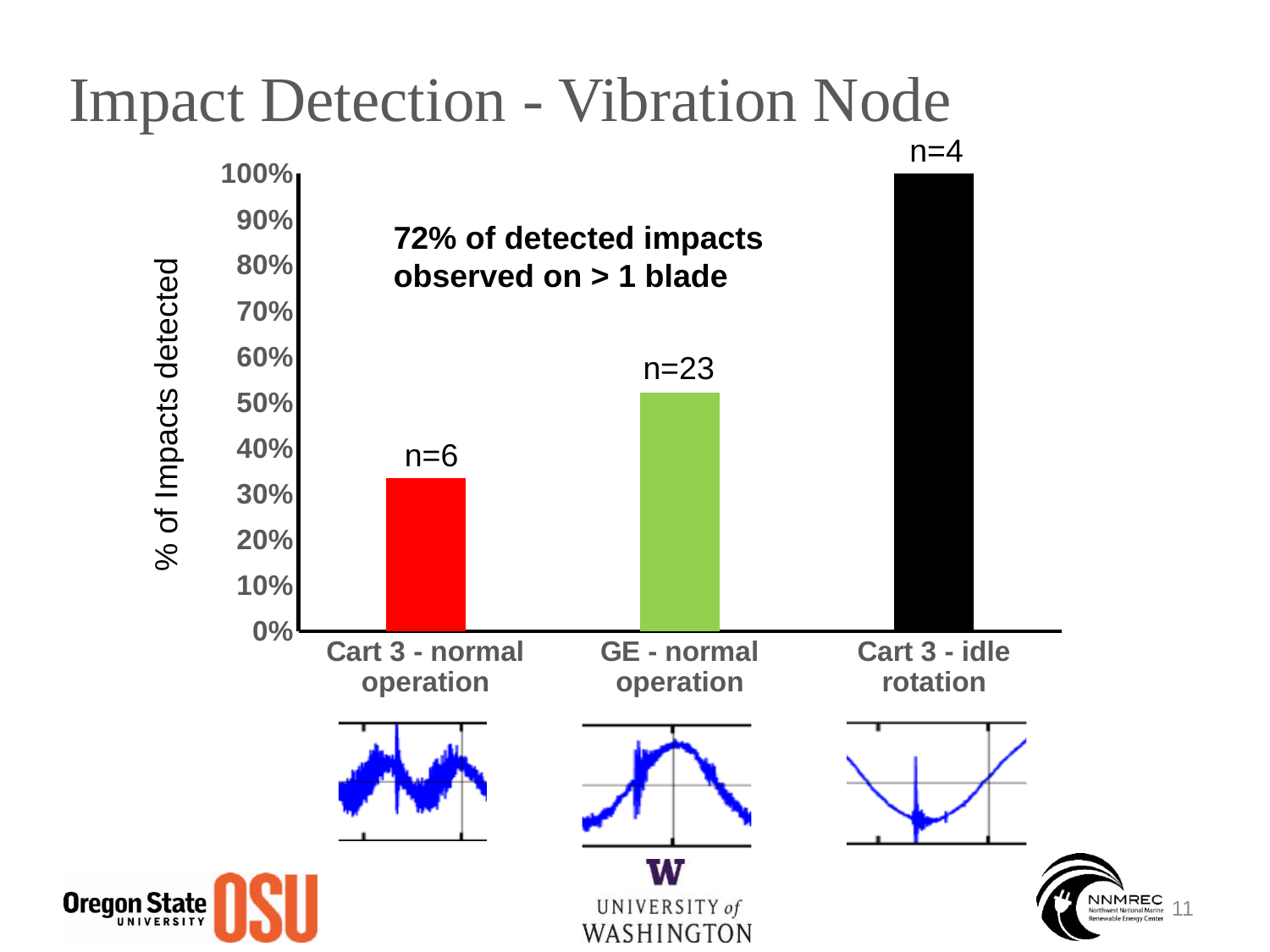
What is the label on the y axis of the chart? % of Impacts detected What is the % of impacts detected for Cart 3 - idle rotation? 100% How many categories are shown on the x axis of the chart? 3 Is the value for GE - normal operation greater or less than 50%? greater What is the n value labelled above the Cart 3 - idle rotation bar? n=4 What is the n value labelled above the GE - normal operation bar? n=23 Is the value for Cart 3 - normal operation greater or less than 40%? less Which is larger, the value for GE - normal operation or the value for Cart 3 - normal operation? GE - normal operation What is the n value labelled above the Cart 3 - normal operation bar? n=6 Which category has the highest % of impacts detected? Cart 3 - idle rotation What kind of chart is shown on the slide? bar chart Which category has the lowest % of impacts detected? Cart 3 - normal operation